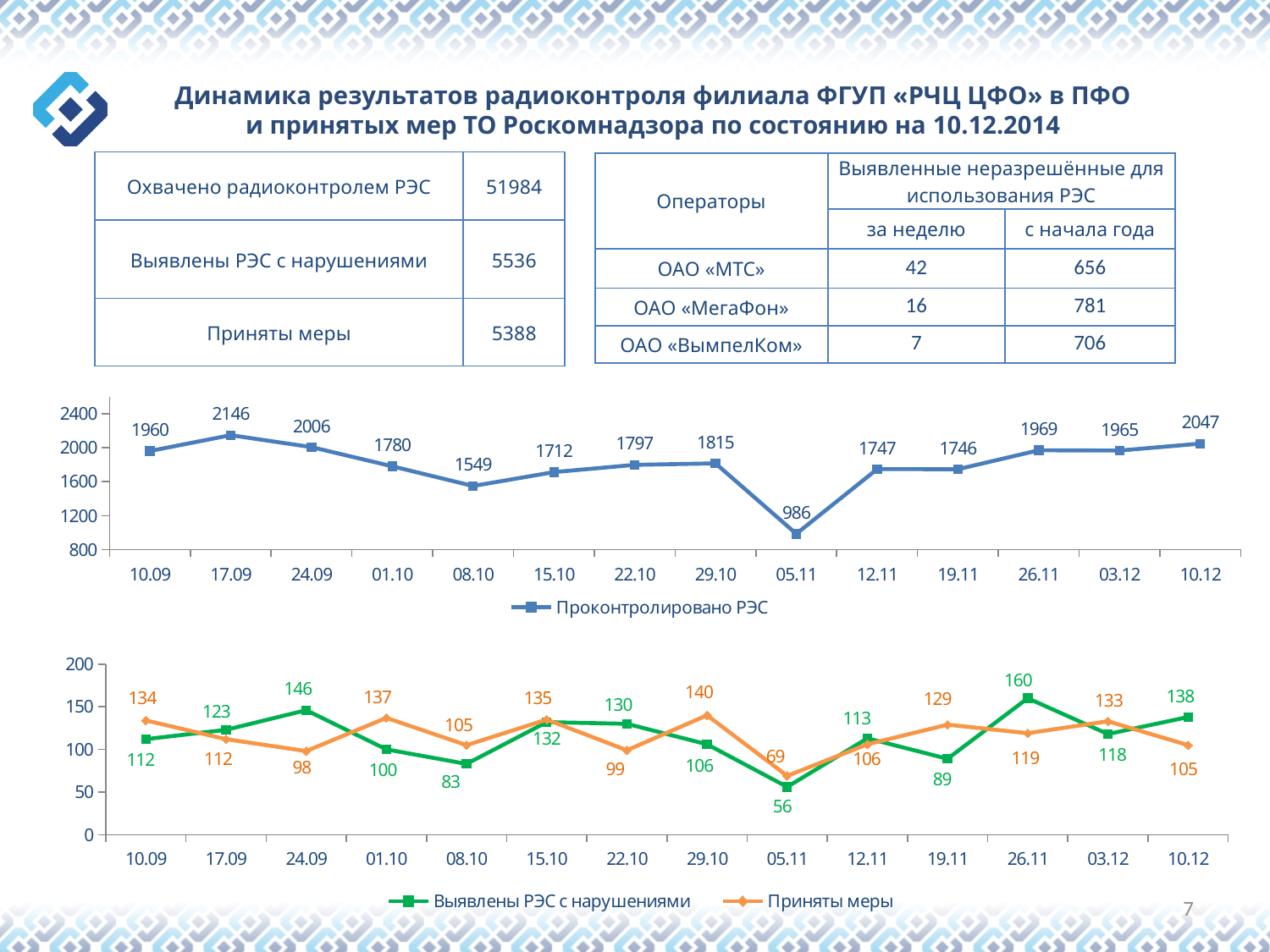
How many series does the legend of the bottom chart list? 2 In the bottom chart, what is the value of Приняты меры for 29.10? 140 In the bottom chart, which is larger on 01.10: Выявлены РЭС с нарушениями or Приняты меры? Приняты меры In the top chart (Проконтролировано РЭС), which date has the lowest value? 05.11 In the bottom chart, which date has the lowest value for Выявлены РЭС с нарушениями? 05.11 What type of chart is the top chart (Проконтролировано РЭС)? Line chart In the top chart (Проконтролировано РЭС), how many data points are plotted? 14 In the bottom chart, what is the difference between Приняты меры and Выявлены РЭС с нарушениями on 08.10? 22 In the bottom chart, what is the value of Выявлены РЭС с нарушениями for 26.11? 160 In the top chart (Проконтролировано РЭС), what is the value for 05.11? 986 In the top chart (Проконтролировано РЭС), what is the difference between the values for 10.12 and 03.12? 82 In the top chart (Проконтролировано РЭС), which date has the highest value? 17.09